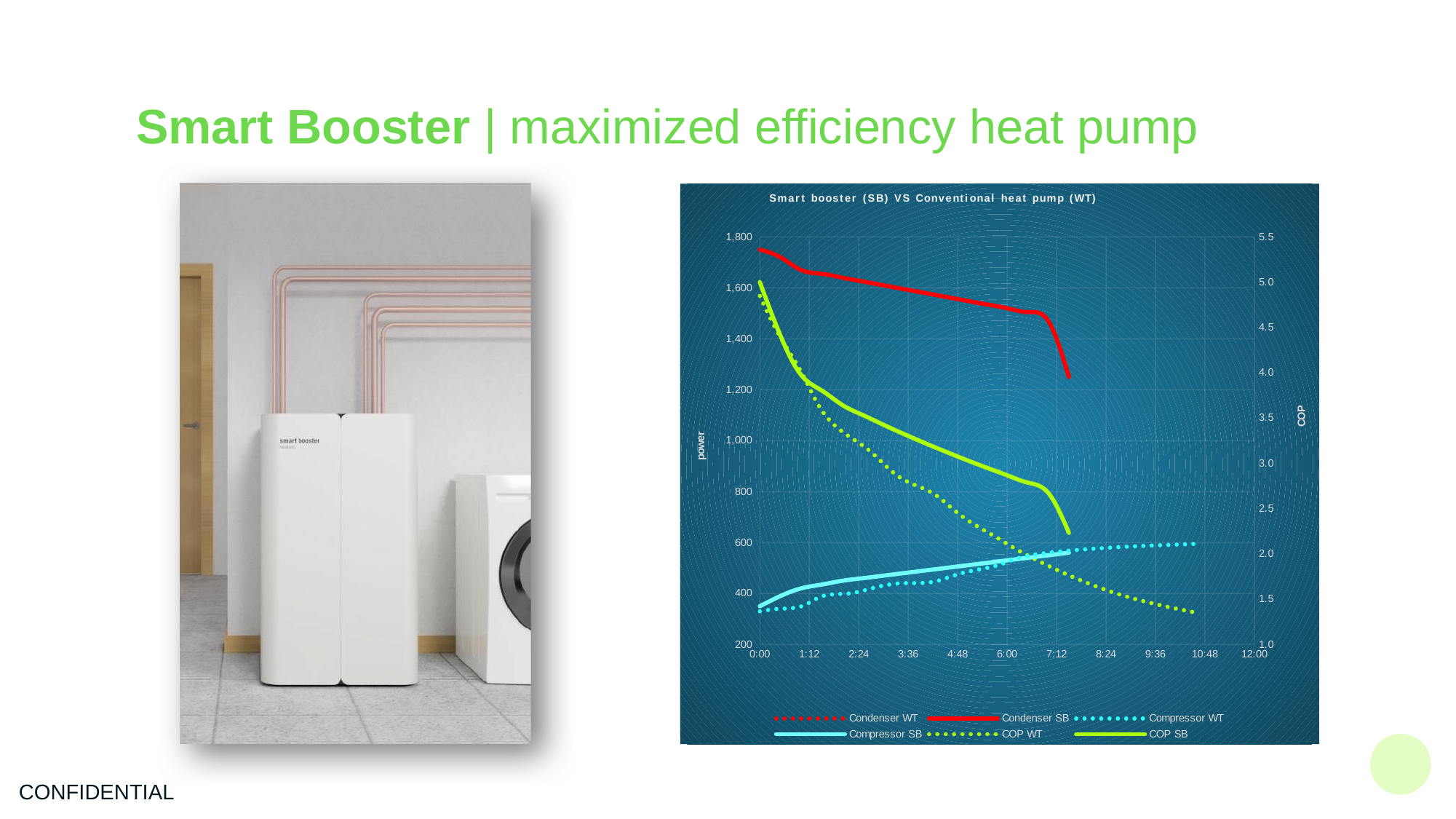
Does the Condenser SB line rise or fall as time increases along the x axis? Fall Does the Compressor SB line rise or fall as time increases along the x axis? Rise How many series does the chart legend list? 6 What type of chart is shown on the slide? Line chart Does the COP WT line rise or fall as time increases along the x axis? Fall Is the value of Compressor WT at 9:36 greater or less than 400? greater At 0:00, which is larger: Condenser SB or Compressor SB? Condenser SB What is the label of the right-hand vertical axis? COP Is the value of Condenser SB at 0:00 greater or less than 1,600? greater Is the value of Compressor SB at 0:00 greater or less than 400? less What is the title of the chart? Smart booster (SB) VS Conventional heat pump (WT) How many time labels are shown on the x axis? 11